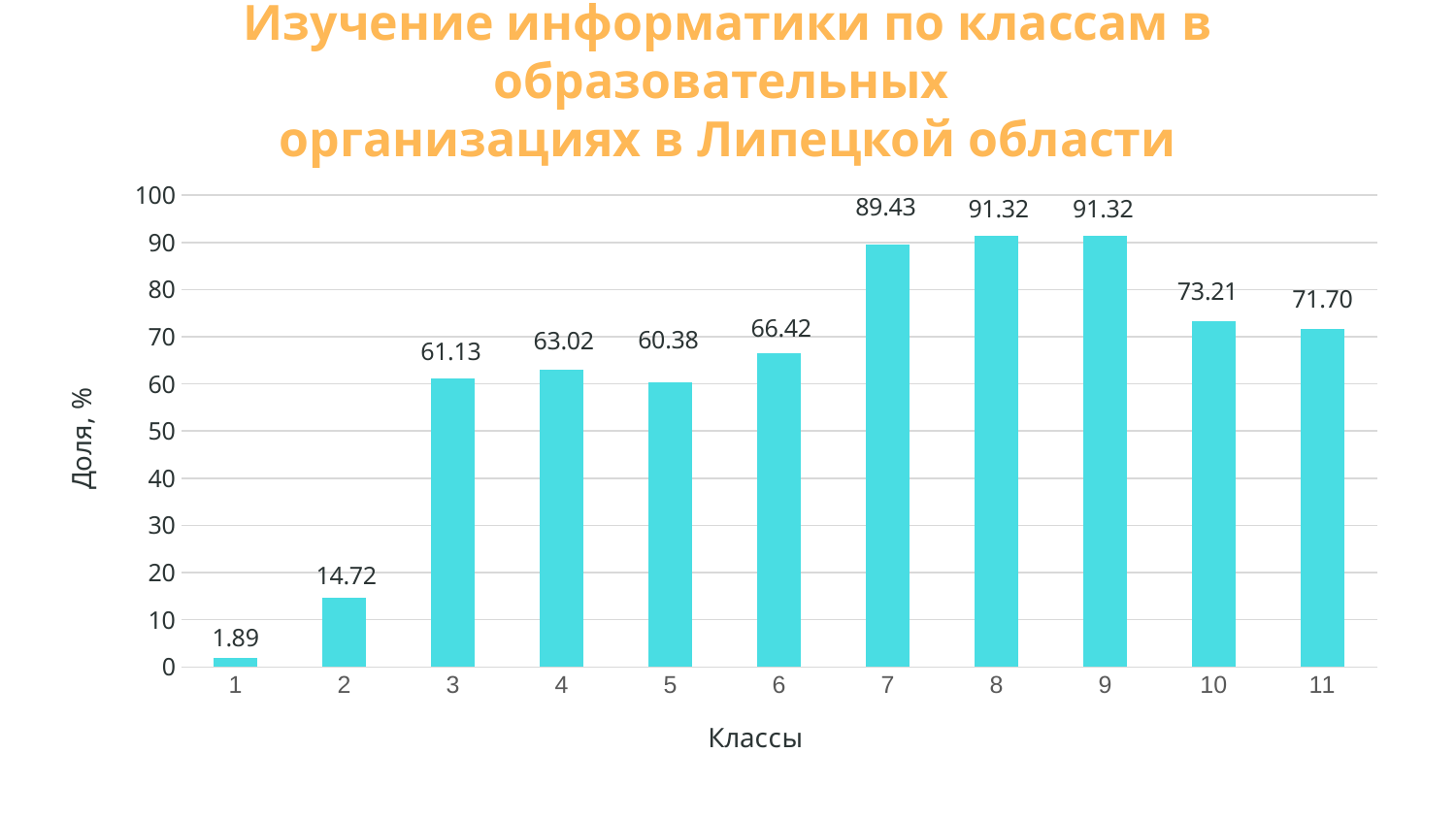
Is the value for class 6 greater or less than 60? greater What is the value for class 2? 14.72 Which is larger, the value for class 4 or the value for class 5? class 4 What is the value for class 11? 71.70 What is the difference between the values for class 10 and class 11? 1.51 Do the values rise or fall from class 1 to class 3? rise How many classes are shown on the x axis? 11 What is the difference between the values for class 7 and class 8? 1.89 What is the value for class 7? 89.43 Which class has the lowest value? 1 What is the label of the y axis? Доля, % What kind of chart is shown on the slide? bar chart